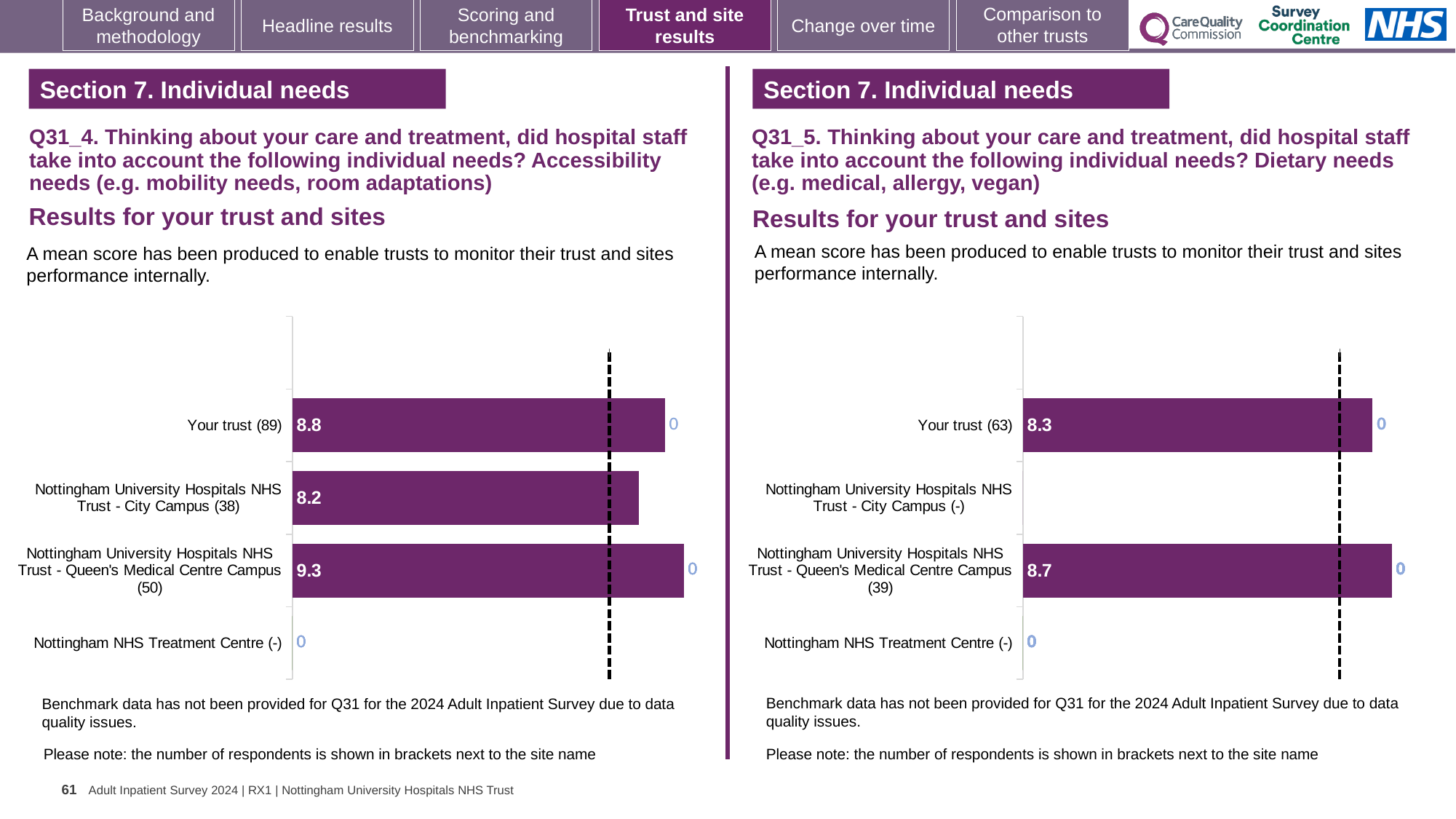
How many respondents are shown for Your trust in the Q31_5 chart (right)? 63 How many category labels are listed on the vertical axis of the Q31_4 chart (left)? 4 In the Q31_4 chart (left), what is the difference between the Queen's Medical Centre Campus score and the City Campus score? 1.1 What type of chart is used on the left for Q31_4? Bar chart In the Q31_4 chart (left), what is the mean score for Nottingham University Hospitals NHS Trust - City Campus? 8.2 In the Q31_5 chart (right), what is the mean score for Nottingham University Hospitals NHS Trust - Queen's Medical Centre Campus? 8.7 In the Q31_4 chart (left), what is the mean score for Nottingham University Hospitals NHS Trust - Queen's Medical Centre Campus? 9.3 In the Q31_5 chart (right), which is larger: the score for Your trust or the score for Queen's Medical Centre Campus? Queen's Medical Centre Campus In the Q31_5 chart (right), what is the mean score for Your trust? 8.3 In the Q31_4 chart (left), what is the mean score for Your trust? 8.8 In the Q31_5 chart (right), what is the difference between the Queen's Medical Centre Campus score and the Your trust score? 0.4 In the Q31_4 chart (left), which site has the highest mean score? Nottingham University Hospitals NHS Trust - Queen's Medical Centre Campus